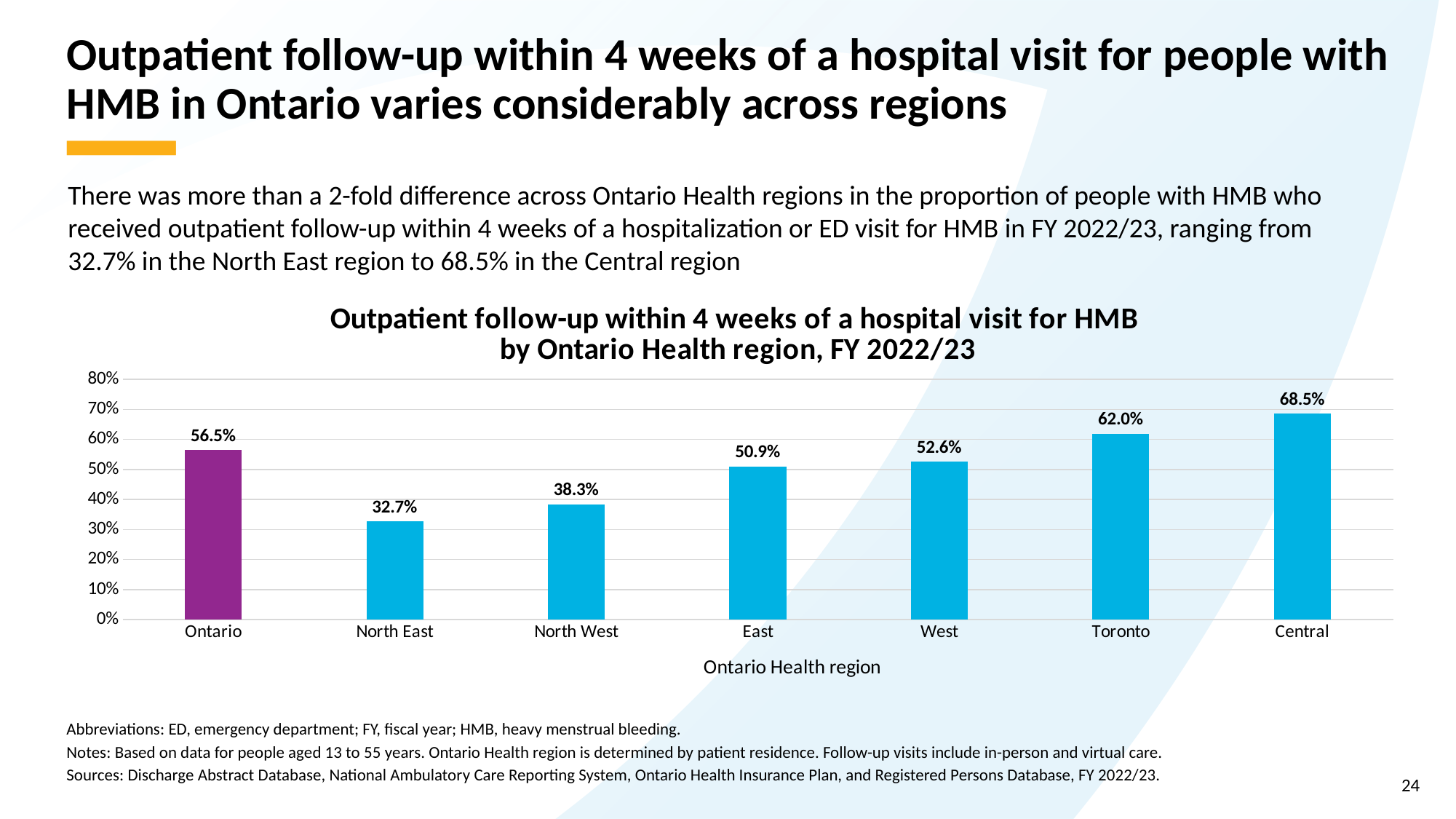
Which region has the lowest value? North East Which is larger, the value for East or the value for West? West What is the value for the Ontario bar? 56.5% What is the value for the North West region? 38.3% What is the difference between the Toronto and West values? 9.4% What is the label of the x axis? Ontario Health region What kind of chart is shown on the slide? bar chart How many bars are shown in the chart? 7 Is the value for North West greater or less than 40%? less What is the value for the Toronto region? 62.0% Which region has the highest value? Central What is the difference between the Central and North East values? 35.8%